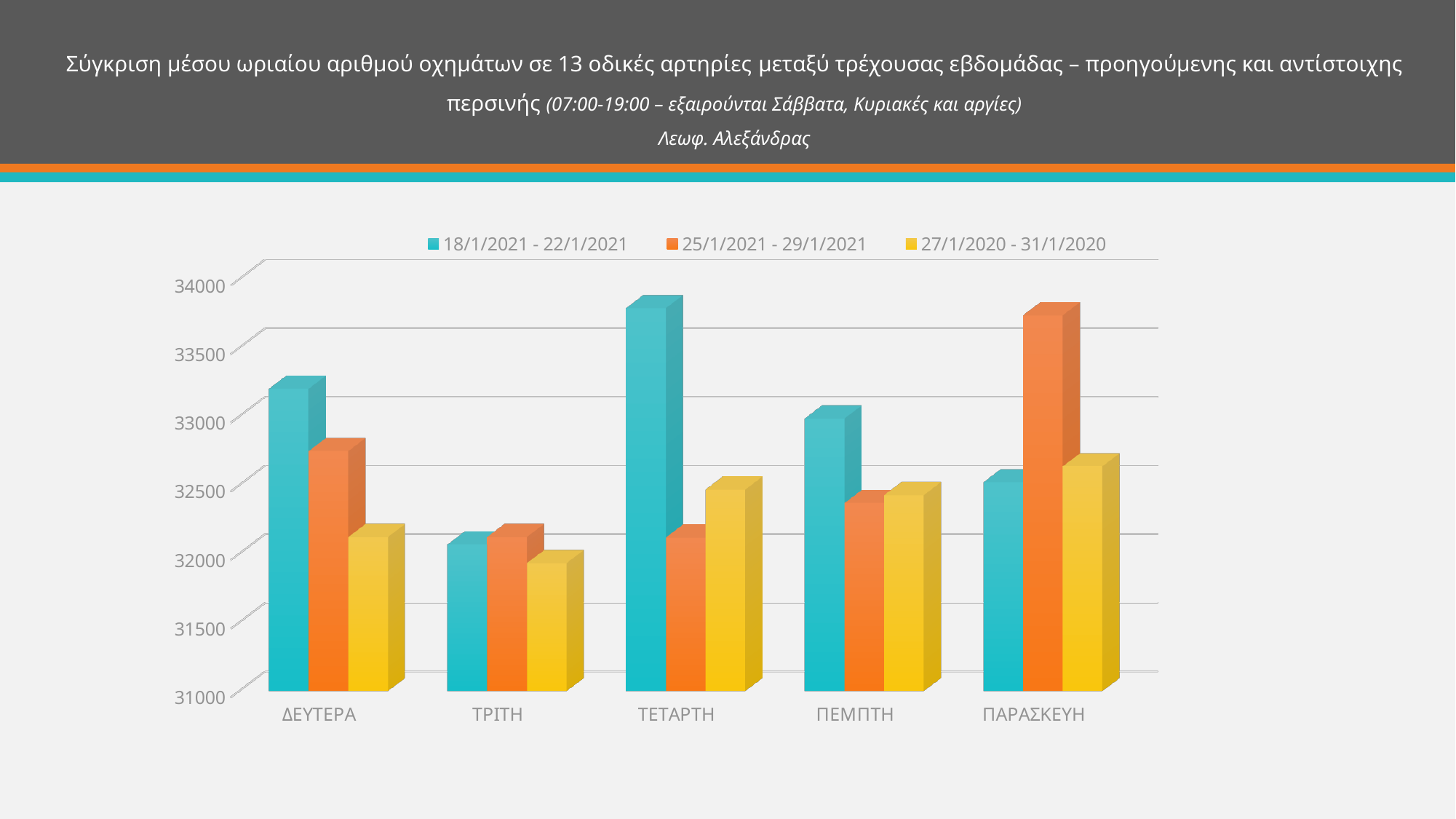
For the series 25/1/2021 - 29/1/2021, which day has the highest value? ΠΑΡΑΣΚΕΥΗ Is the value for ΤΕΤΑΡΤΗ in the series 18/1/2021 - 22/1/2021 greater or less than 33500? greater Is the value for ΤΕΤΑΡΤΗ in the series 25/1/2021 - 29/1/2021 greater or less than 32500? less How many categories (days) are shown on the x axis? 5 Which road is named in the chart title below the main heading? Λεωφ. Αλεξάνδρας For ΠΑΡΑΣΚΕΥΗ, which series has the larger value: 18/1/2021 - 22/1/2021 or 25/1/2021 - 29/1/2021? 25/1/2021 - 29/1/2021 Is the value for ΔΕΥΤΕΡΑ in the series 18/1/2021 - 22/1/2021 greater or less than 33000? greater How many series does the legend list? 3 For the series 18/1/2021 - 22/1/2021, which day has the highest value? ΤΕΤΑΡΤΗ What kind of chart is shown on the slide? bar chart For the series 27/1/2020 - 31/1/2020, which day has the lowest value? ΤΡΙΤΗ For the series 18/1/2021 - 22/1/2021, which day has the lowest value? ΤΡΙΤΗ